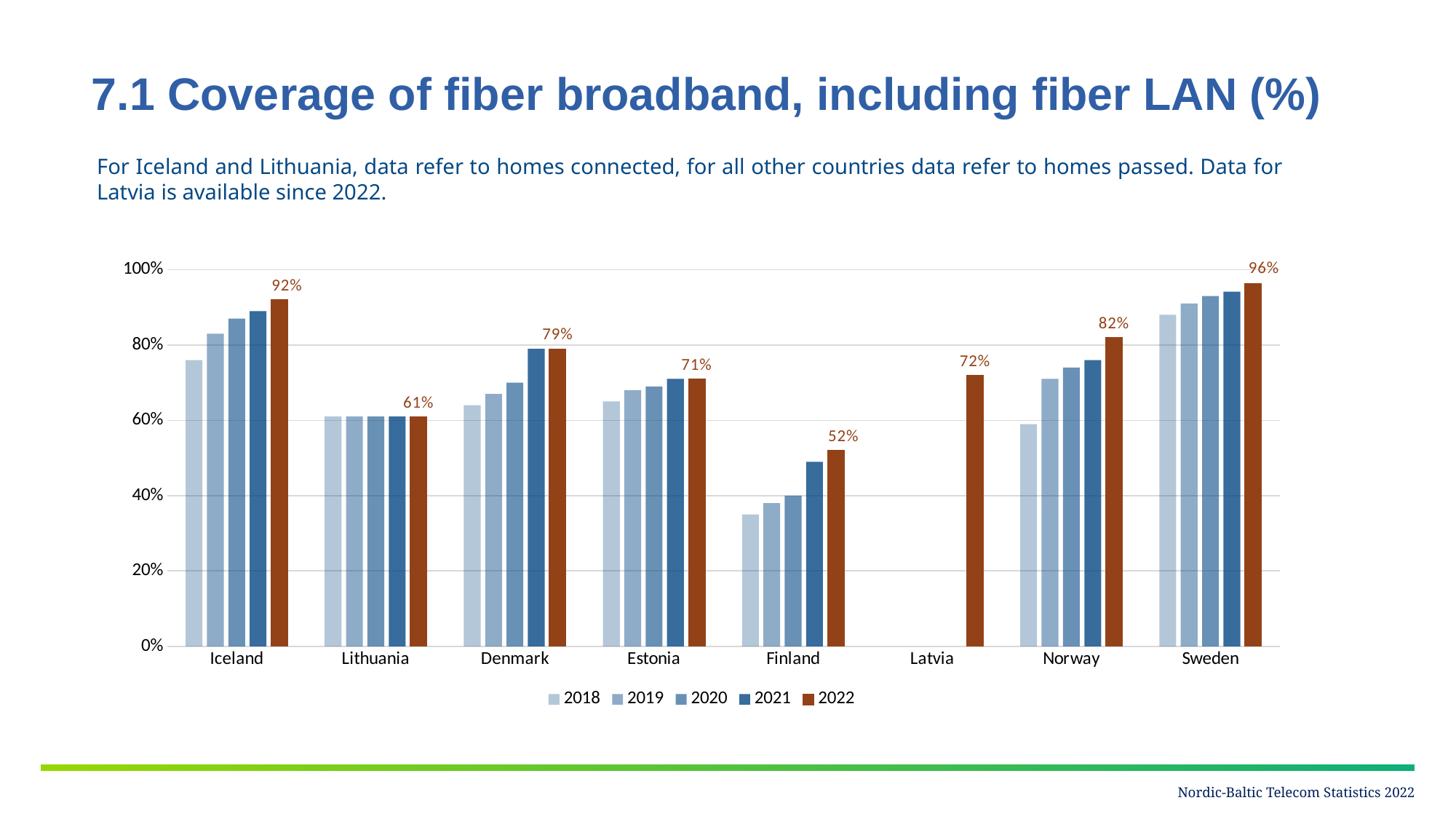
What is the 2022 value for Sweden? 96% Which country has the highest 2022 value? Sweden How many countries are shown on the x axis? 8 What is the 2022 value for Latvia? 72% How many series does the legend list? 5 What is the 2022 value for Finland? 52% Is the 2018 value for Iceland greater or less than 60%? greater What kind of chart is shown on the slide? bar chart Which has the larger 2022 value, Norway or Estonia? Norway Is the 2018 value for Finland greater or less than 40%? less What is the difference between the 2022 values for Iceland and Denmark? 13% Which country has the lowest 2022 value? Finland